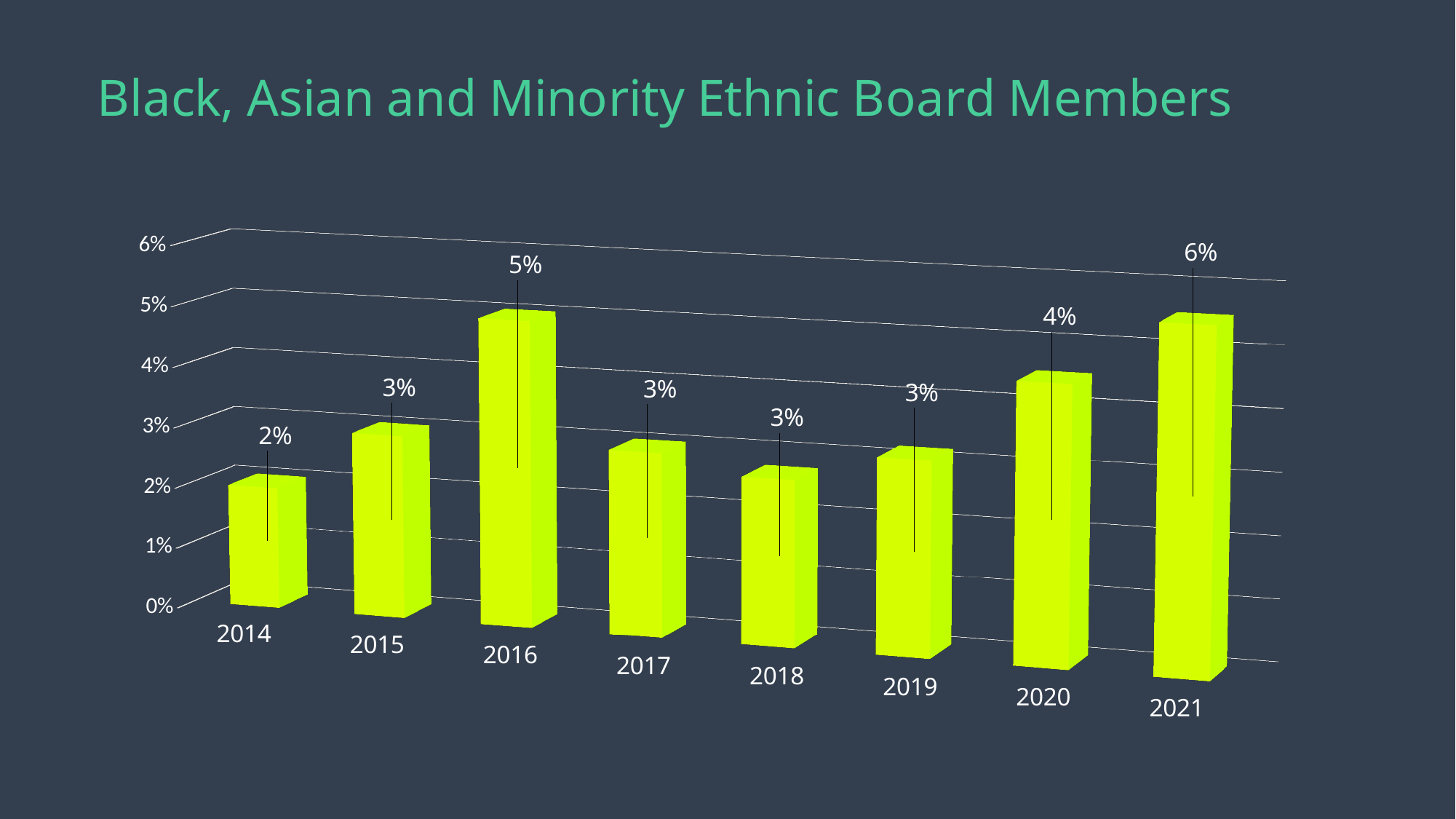
What is the value for 2014? 2% How many years are shown on the chart? 8 What kind of chart is shown on the slide? bar chart What is the title of the chart? Black, Asian and Minority Ethnic Board Members What is the difference between the values for 2021 and 2014? 4% Which year has the lowest value? 2014 Which year has the highest value? 2021 What is the value for 2021? 6% Which is larger, the value for 2016 or the value for 2020? 2016 What is the difference between the values for 2016 and 2017? 2% What is the value for 2016? 5% What is the value for 2020? 4%